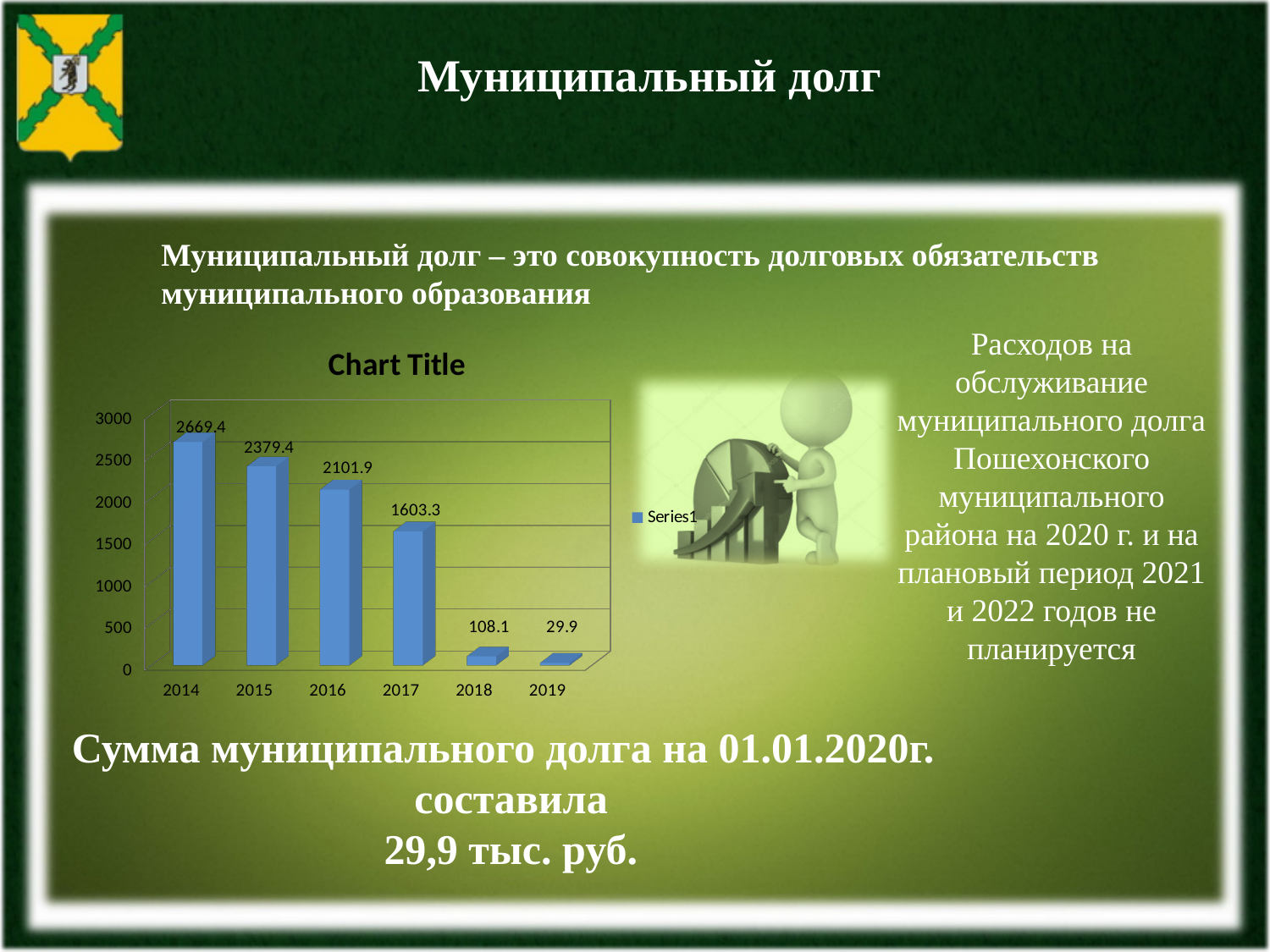
What is the difference between the values for 2015 and 2016? 277.5 Which year has the lowest value? 2019 What is the difference between the values for 2018 and 2019? 78.2 What is the value for 2017? 1603.3 What is the value for 2019? 29.9 How many years are shown on the x axis? 6 What kind of chart is shown? bar chart Is the value for 2015 greater or less than 2000? greater Which year has the highest value? 2014 Which is larger, the value for 2016 or the value for 2017? 2016 What is the value for 2014? 2669.4 Do the values rise or fall from 2014 to 2019? fall